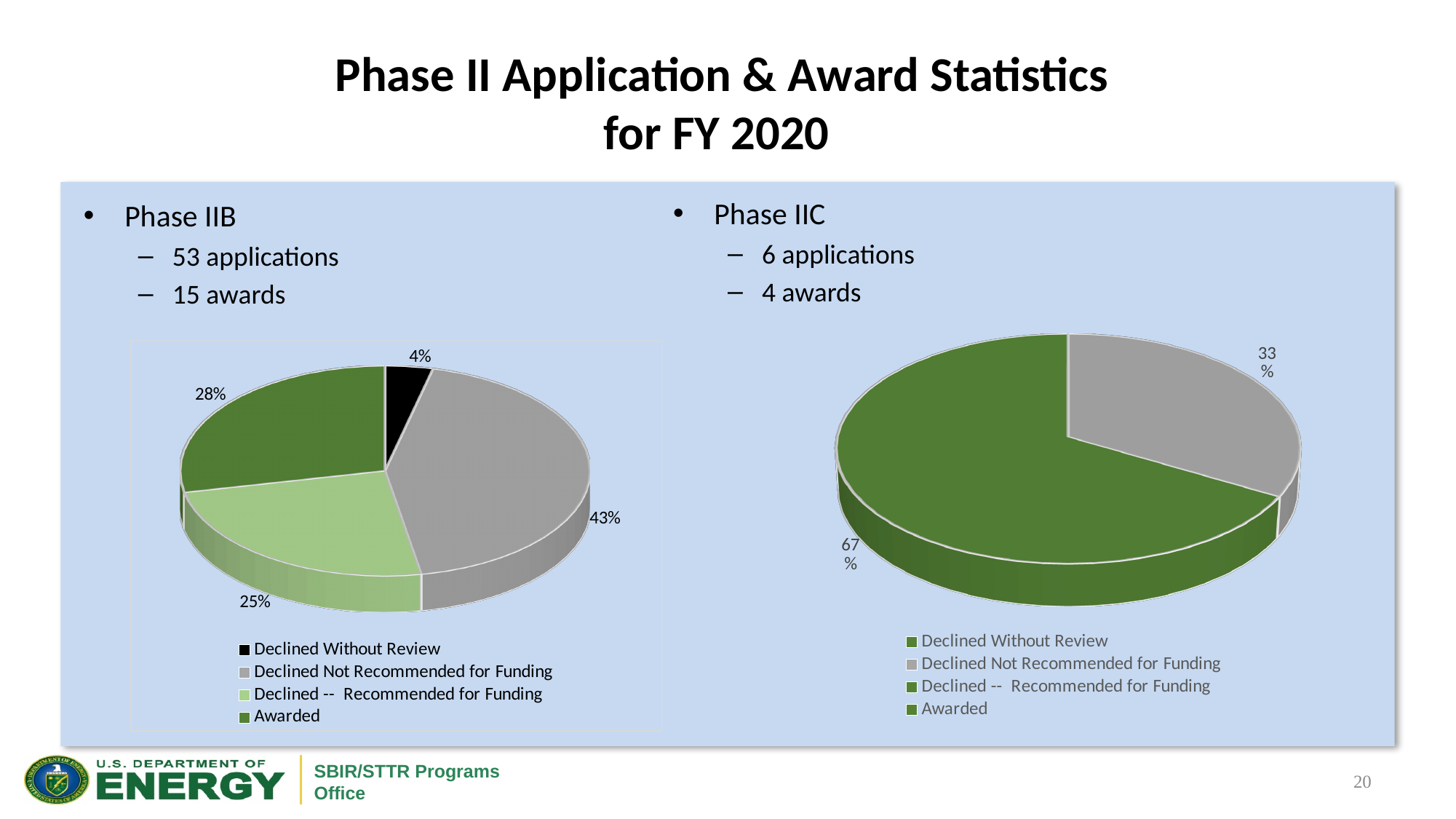
In the Phase IIB pie chart on the left, what is the difference in percentage points between Declined Not Recommended for Funding and Awarded? 15 In the Phase IIB pie chart on the left, which category has the smallest slice? Declined Without Review In the Phase IIC pie chart on the right, what is the percentage of the largest slice? 67% In the Phase IIB pie chart on the left, what share is Declined -- Recommended for Funding? 25% In the Phase IIC pie chart on the right, what share is Declined Not Recommended for Funding? 33% How many entries does the legend of the Phase IIB pie chart on the left list? 4 In the Phase IIB pie chart on the left, which is larger: Awarded or Declined -- Recommended for Funding? Awarded What kind of charts are shown on the slide? Pie charts In the Phase IIB pie chart on the left, what share is Declined Without Review? 4% In the Phase IIB pie chart on the left, which category has the largest slice? Declined Not Recommended for Funding In the Phase IIB pie chart on the left, what share is Declined Not Recommended for Funding? 43% In the Phase IIB pie chart on the left, what share is Awarded? 28%